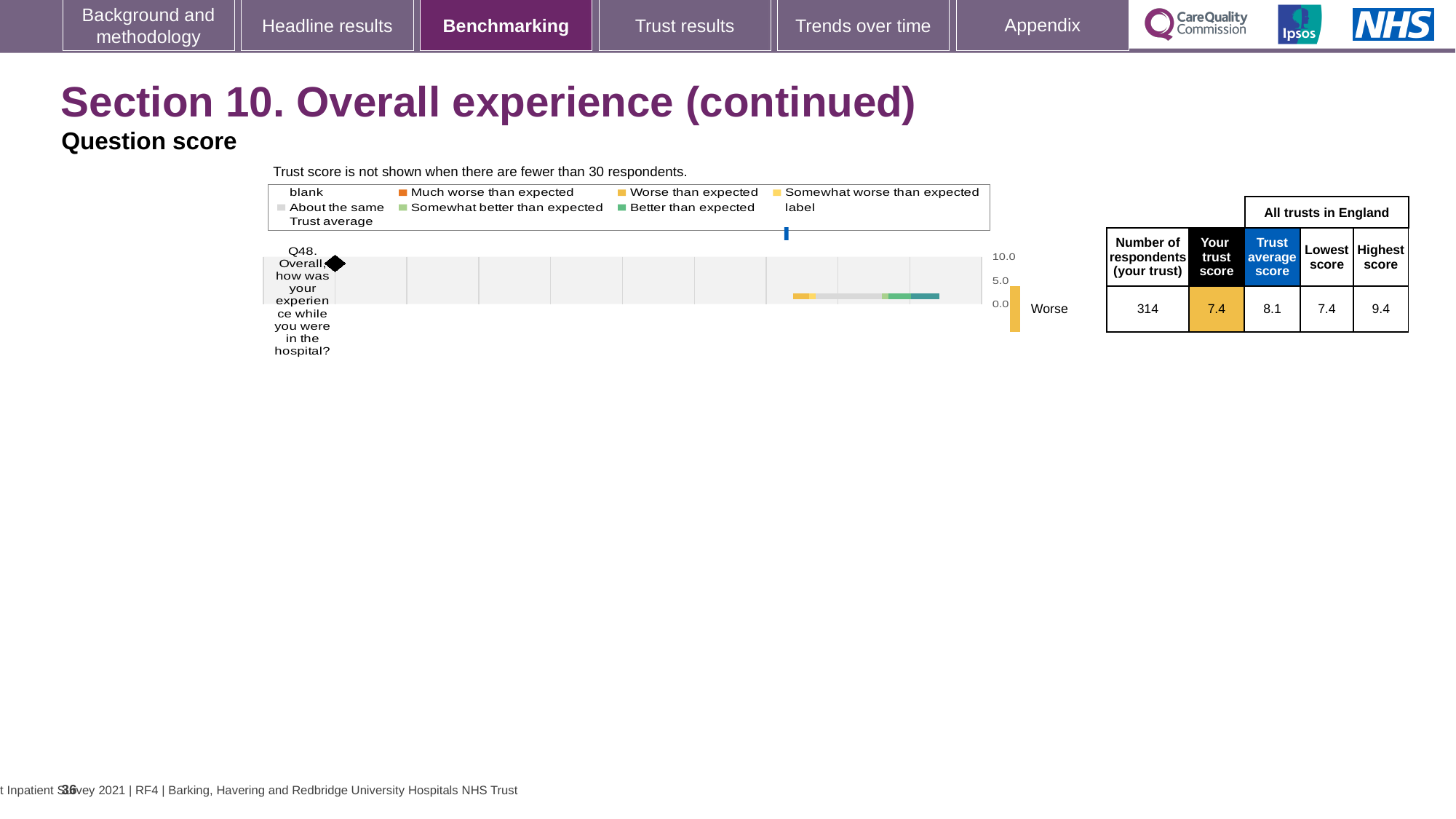
Which question is plotted in the benchmarking chart? Q48. Overall, how was your experience while you were in the hospital? In the table next to the chart, what is the lowest score among all trusts in England for Q48? 7.4 In the table next to the chart, what is the trust average score for Q48? 8.1 How many questions are plotted as categories in the benchmarking chart? 1 In the table next to the chart, what is the highest score among all trusts in England for Q48? 9.4 What is the highest value shown on the chart's score axis? 10.0 What is the difference between the trust average score and your trust score for Q48? 0.7 What kind of chart is used to show the Q48 benchmarking result? bar chart In the table next to the chart, what is the number of respondents for your trust for Q48? 314 Which is larger for Q48: your trust score or the trust average score? Trust average score What is the difference between the highest score and the lowest score for Q48 in the table? 2.0 In the table next to the chart, what is your trust score for Q48? 7.4